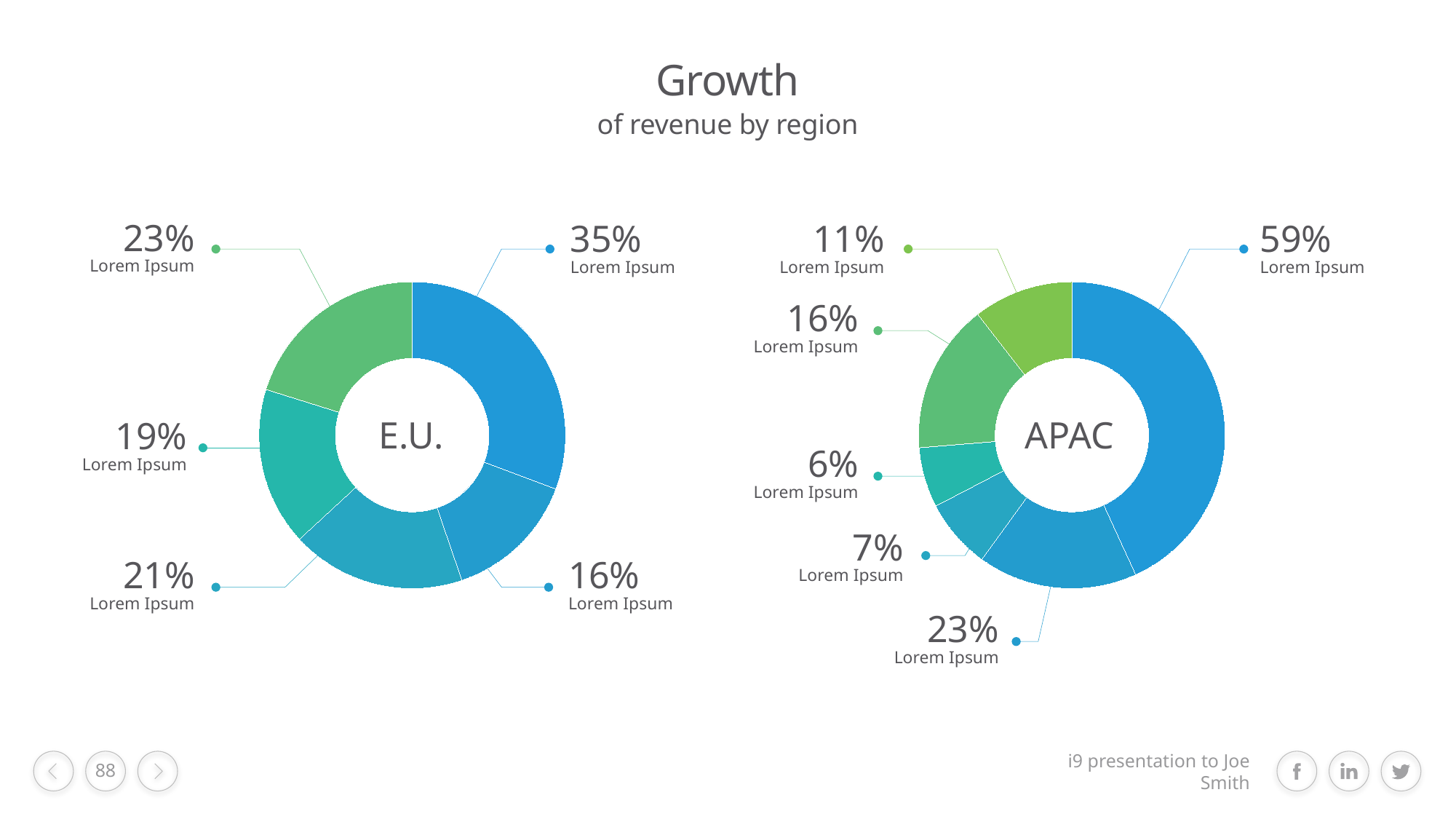
How many slices does the APAC donut chart on the right have? 6 In the APAC chart on the right, what is the difference between the largest slice (59%) and the smallest slice (6%)? 53 percentage points What is the title shown above the two charts? Growth of revenue by region What kind of chart is used for the E.U. chart on the left? donut chart Which chart has the larger biggest slice, the E.U. chart or the APAC chart? APAC In the E.U. chart on the left, what is the value of the smallest slice? 16% In the APAC chart on the right, what is the value of the smallest slice? 6% How many slices does the E.U. donut chart on the left have? 5 In the E.U. chart on the left, what is the value of the largest slice? 35% In the APAC chart on the right, what value is labelled for the light green slice at the top? 11% In the E.U. chart on the left, what is the difference between the largest slice (35%) and the smallest slice (16%)? 19 percentage points In the APAC chart on the right, what is the value of the largest slice? 59%